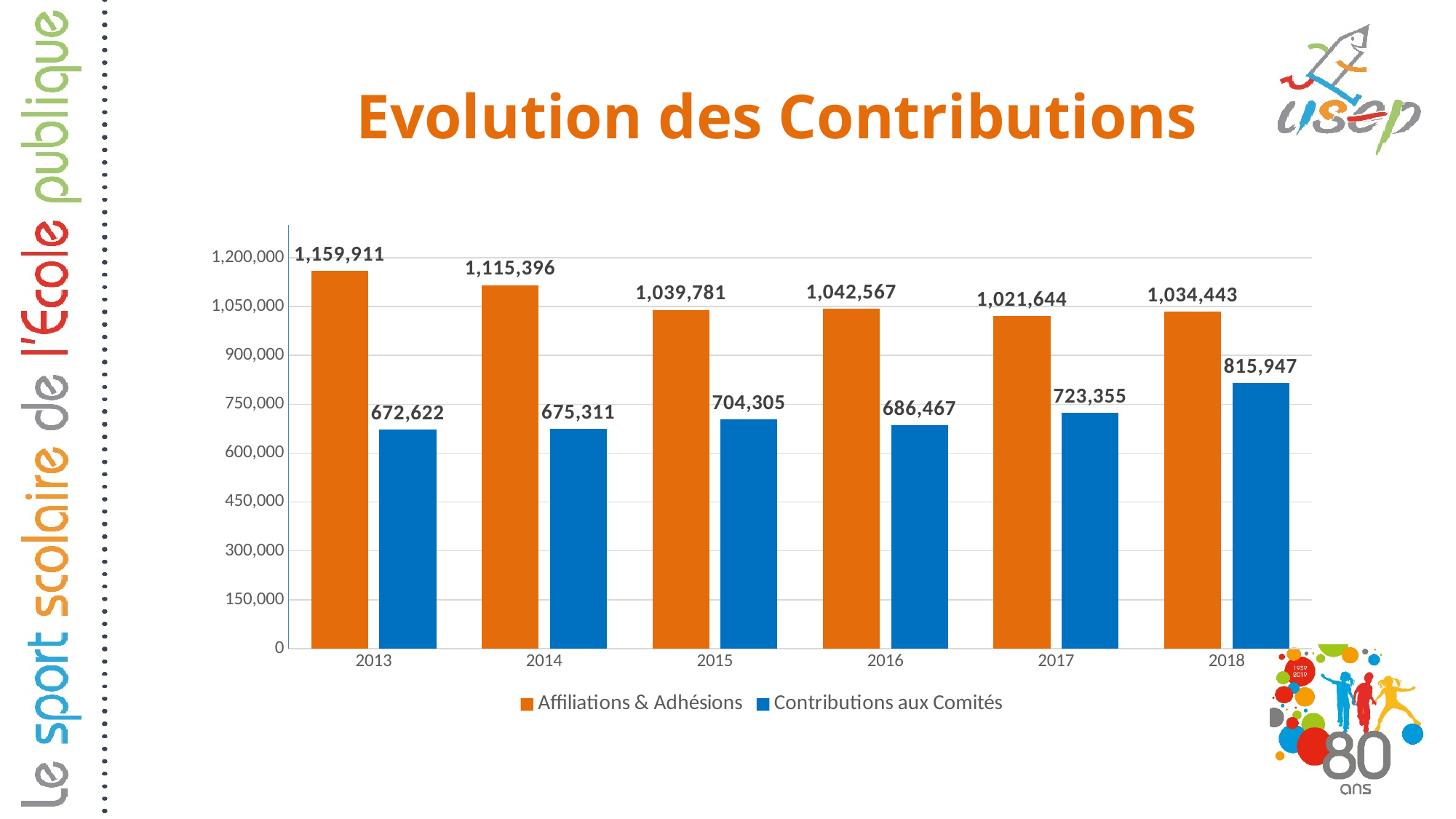
In which year is Affiliations & Adhésions lowest? 2017 By how much did Contributions aux Comités increase from 2013 to 2018? 143,325 What is the value of Contributions aux Comités in 2015? 704,305 What is the value of Affiliations & Adhésions in 2013? 1,159,911 What type of chart is shown on the slide? Bar chart What is the difference between Affiliations & Adhésions and Contributions aux Comités in 2013? 487,289 In which year is Affiliations & Adhésions highest? 2013 Which is larger in 2016: Affiliations & Adhésions or Contributions aux Comités? Affiliations & Adhésions What is the value of Contributions aux Comités in 2018? 815,947 In which year is Contributions aux Comités highest? 2018 How many years are shown on the x axis? 6 How many series does the legend list? 2